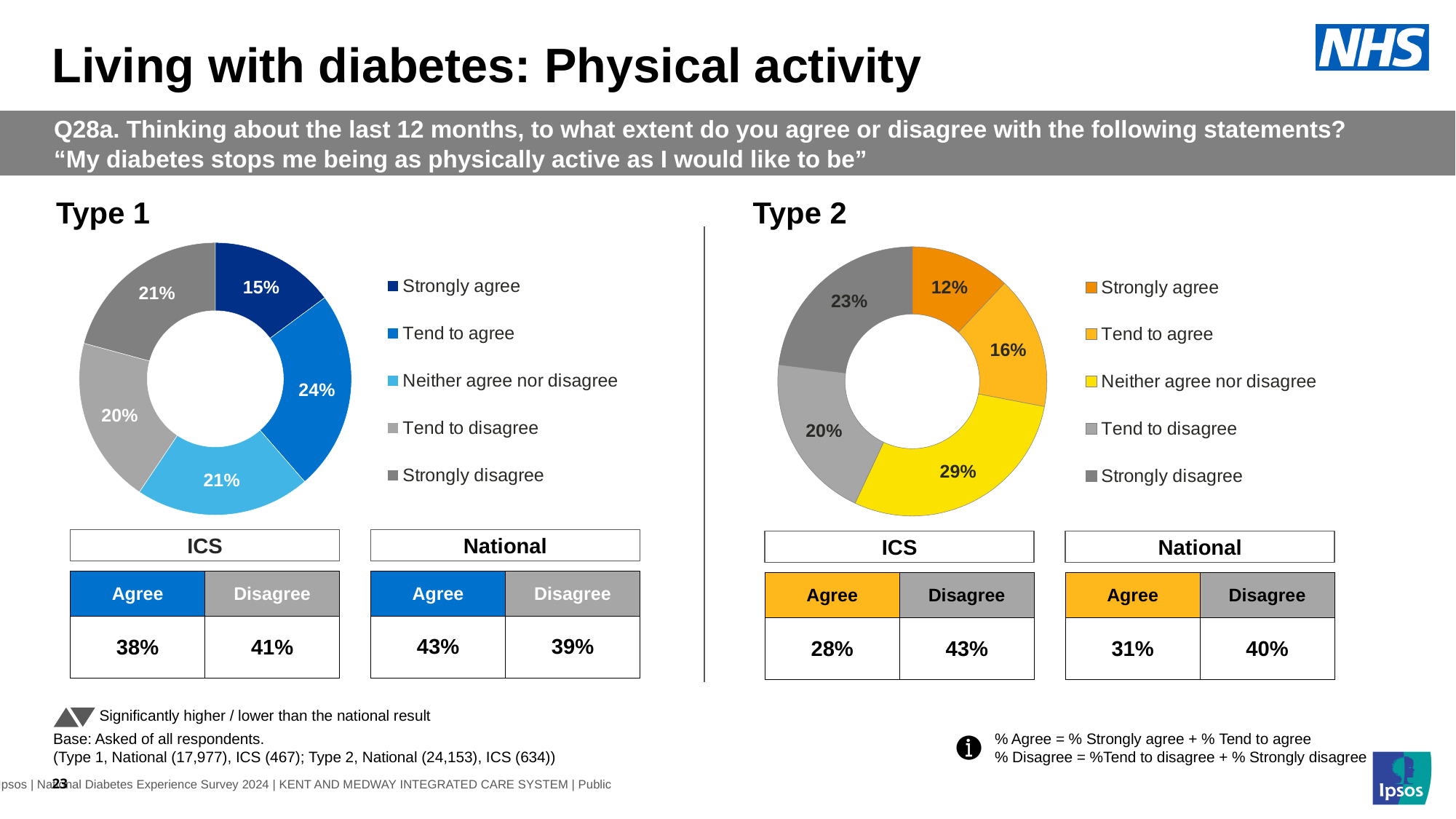
In the Type 2 chart, what percentage of respondents said they strongly disagree? 23% In the Type 1 chart, what percentage of respondents said they tend to disagree? 20% In the Type 2 chart, which response category has the smallest share? Strongly agree In the Type 1 chart, which is larger: the share for 'Tend to agree' or the share for 'Strongly agree'? Tend to agree In the Type 1 chart, which response category has the largest share? Tend to agree In the Type 2 chart, what percentage of respondents said they neither agree nor disagree? 29% In the Type 2 chart, what colour is the 'Neither agree nor disagree' segment? Yellow What kind of chart is used for the Type 1 data? Doughnut chart In the Type 1 chart, what is the combined share of 'Strongly agree' and 'Tend to agree'? 39% In the Type 1 chart, what percentage of respondents said they strongly agree? 15% How many response categories does the Type 2 chart show? 5 In the Type 2 chart, what is the difference in percentage points between 'Neither agree nor disagree' and 'Tend to agree'? 13